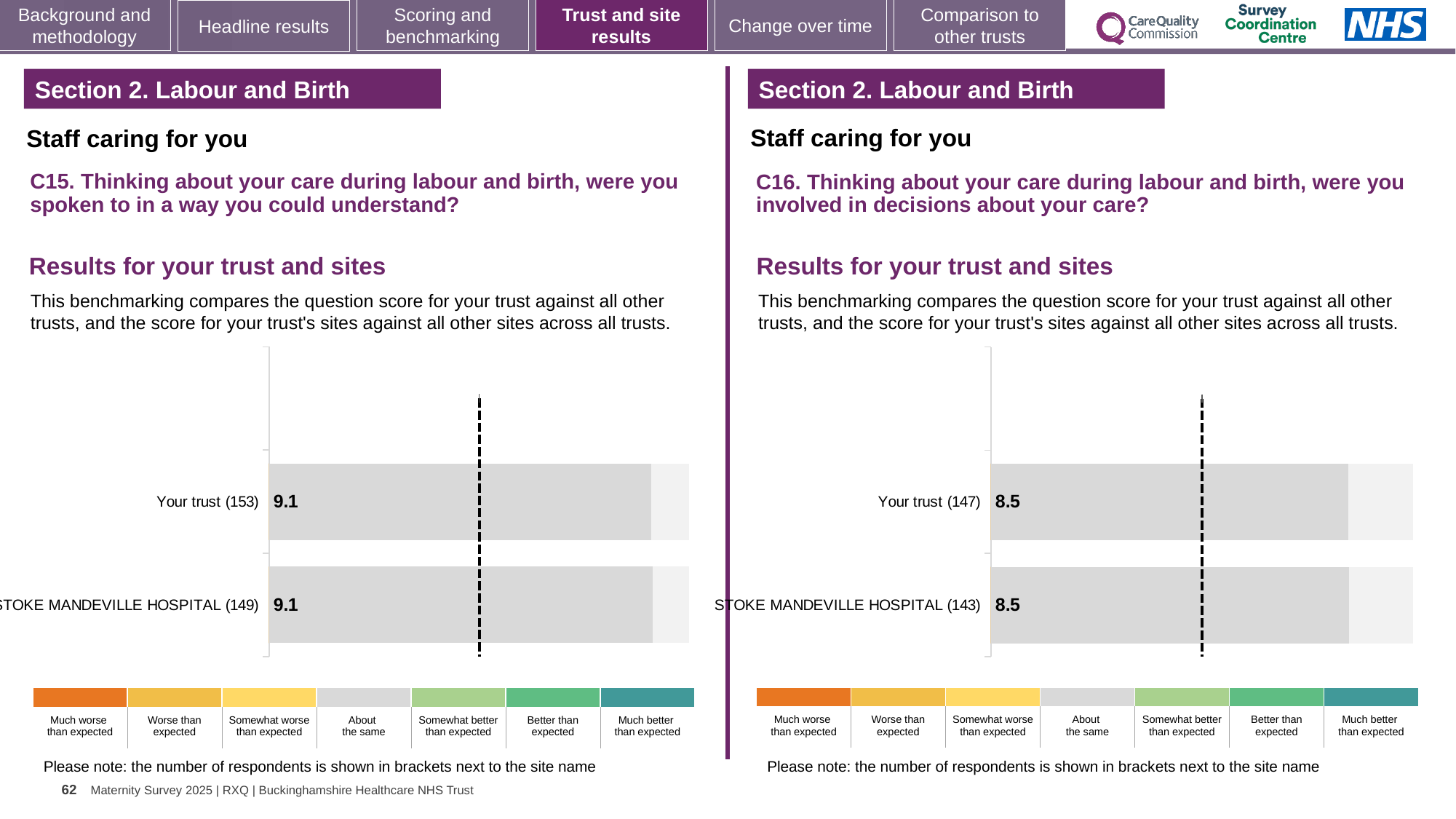
On the left chart (C15), what is the score for STOKE MANDEVILLE HOSPITAL? 9.1 On the right chart (C16), what is the score for Your trust? 8.5 On the left chart (C15), what is the difference between the Your trust score and the STOKE MANDEVILLE HOSPITAL score? 0.0 What kind of chart is used on the left (C15)? Bar chart How many categories does the colour key below each chart list? 7 On the right chart (C16), how many respondents are shown in brackets for STOKE MANDEVILLE HOSPITAL? 143 How many bars are plotted on the right chart (C16)? 2 On the right chart (C16), what is the score for STOKE MANDEVILLE HOSPITAL? 8.5 On the left chart (C15), what is the score for Your trust? 9.1 On the left chart (C15), how many respondents are shown in brackets for Your trust? 153 How many bars are plotted on the left chart (C15)? 2 On the right chart (C16), what is the difference between the Your trust score and the STOKE MANDEVILLE HOSPITAL score? 0.0